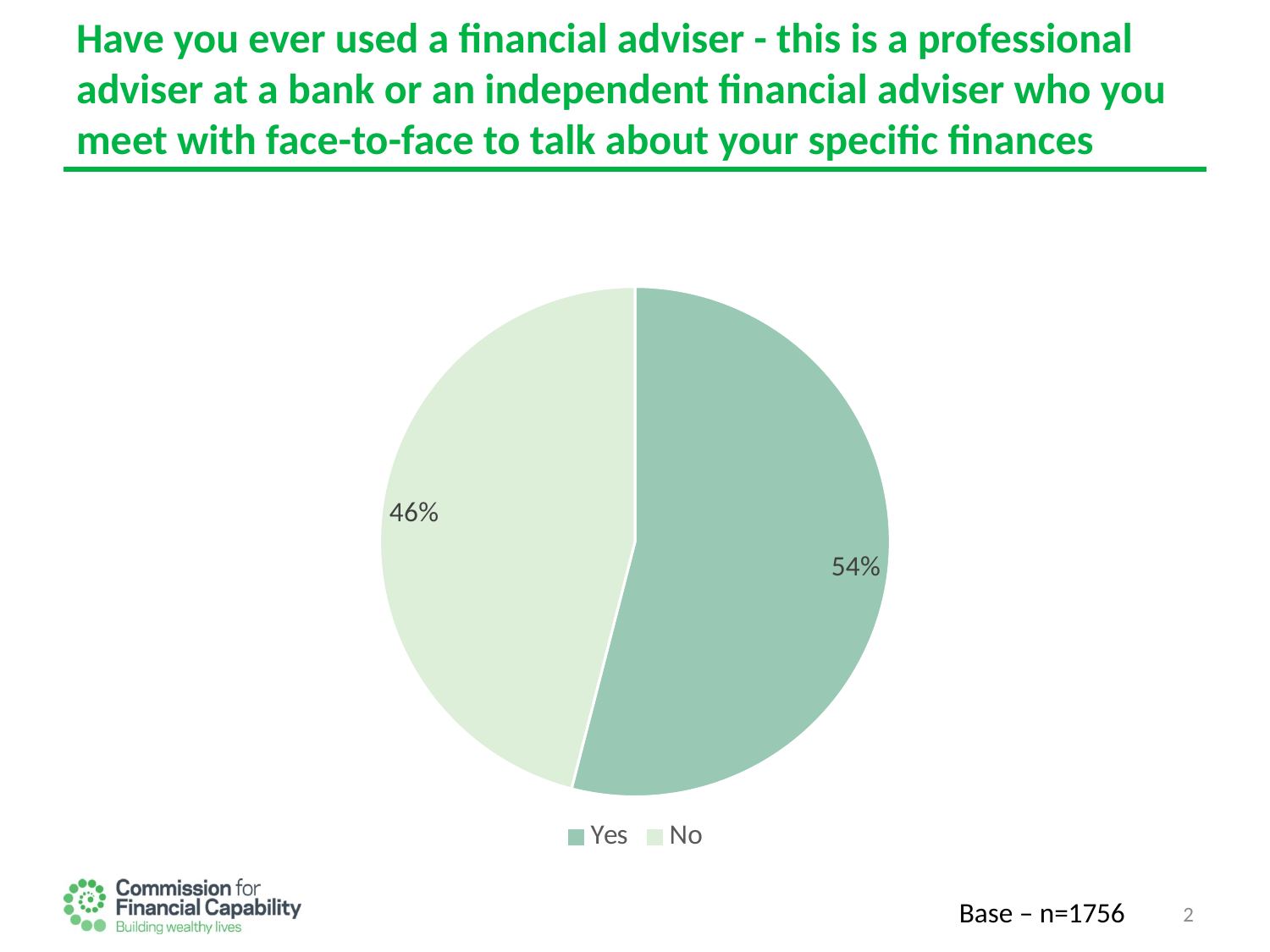
Which response has the larger share of the pie? Yes Is the share for Yes larger or smaller than the share for No? larger What share of the pie does the No slice represent? 46% Which legend entry is shown in the darker green colour? Yes What is the difference in percentage points between the Yes and No shares? 8 What percentage of respondents answered Yes? 54% Which response has the smaller share of the pie? No What percentage of respondents answered No? 46% How many entries does the legend list? 2 What kind of chart is shown on the slide? pie chart What is the base sample size shown on the slide? n=1756 How many slices does the pie chart have? 2